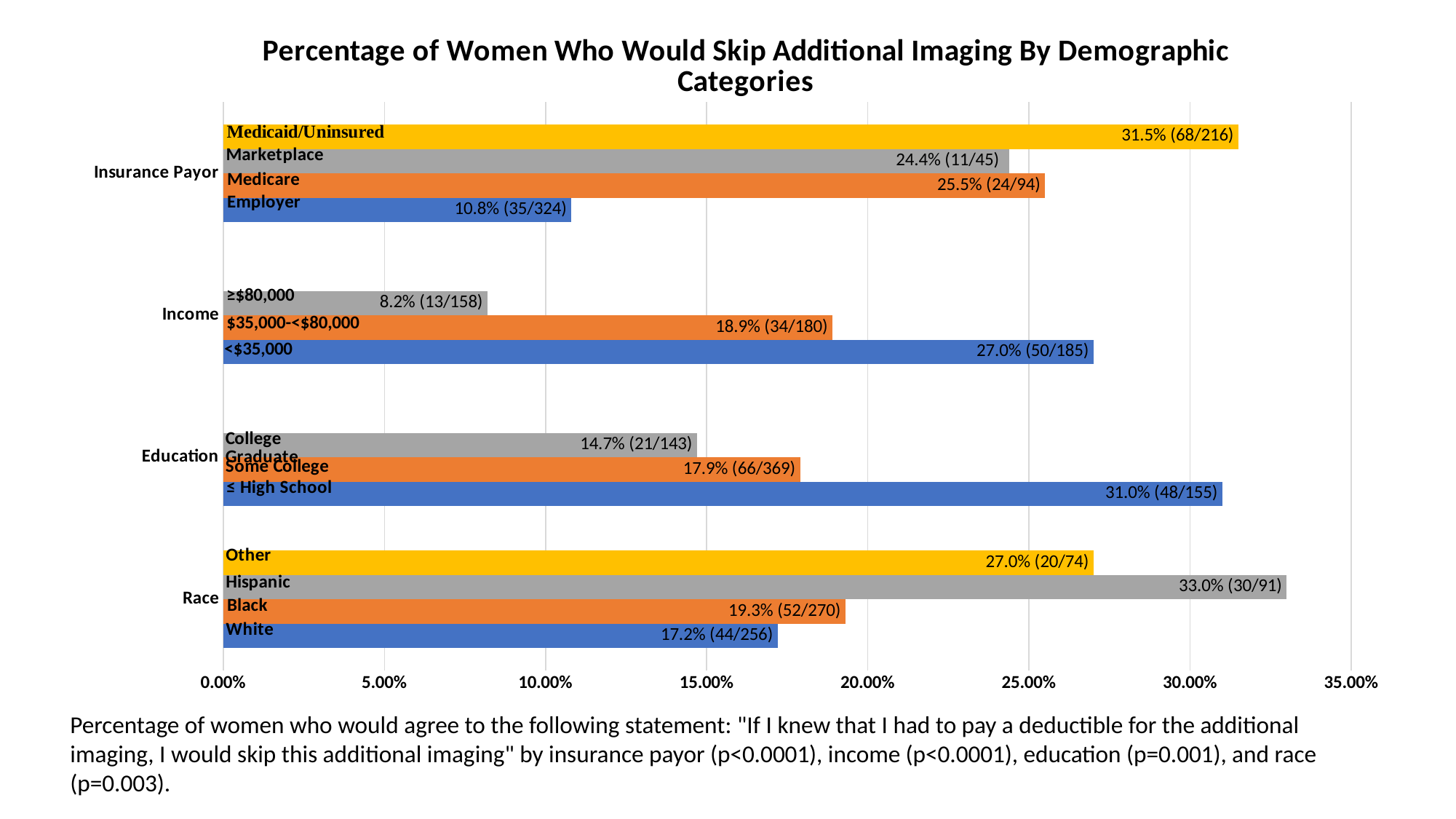
Which insurance payor category has the highest percentage of women who would skip additional imaging? Medicaid/Uninsured What fraction (count) is printed next to the ≤ High School bar? 48/155 What percentage is shown for the Hispanic bar in the Race group? 33.0% What type of chart is shown on the slide? Bar chart Is the value for Some College greater or less than 20.00%? less What is the difference in percentage points between the <$35,000 and ≥$80,000 income categories? 18.8 percentage points Which category across the whole chart has the lowest percentage? ≥$80,000 What is the title of the chart? Percentage of Women Who Would Skip Additional Imaging By Demographic Categories What is the value shown for the ≥$80,000 income category? 8.2% What percentage of women with Employer insurance would skip additional imaging? 10.8% How many bars are shown in the Race group? 4 Which has a higher percentage, Medicare or Marketplace? Medicare